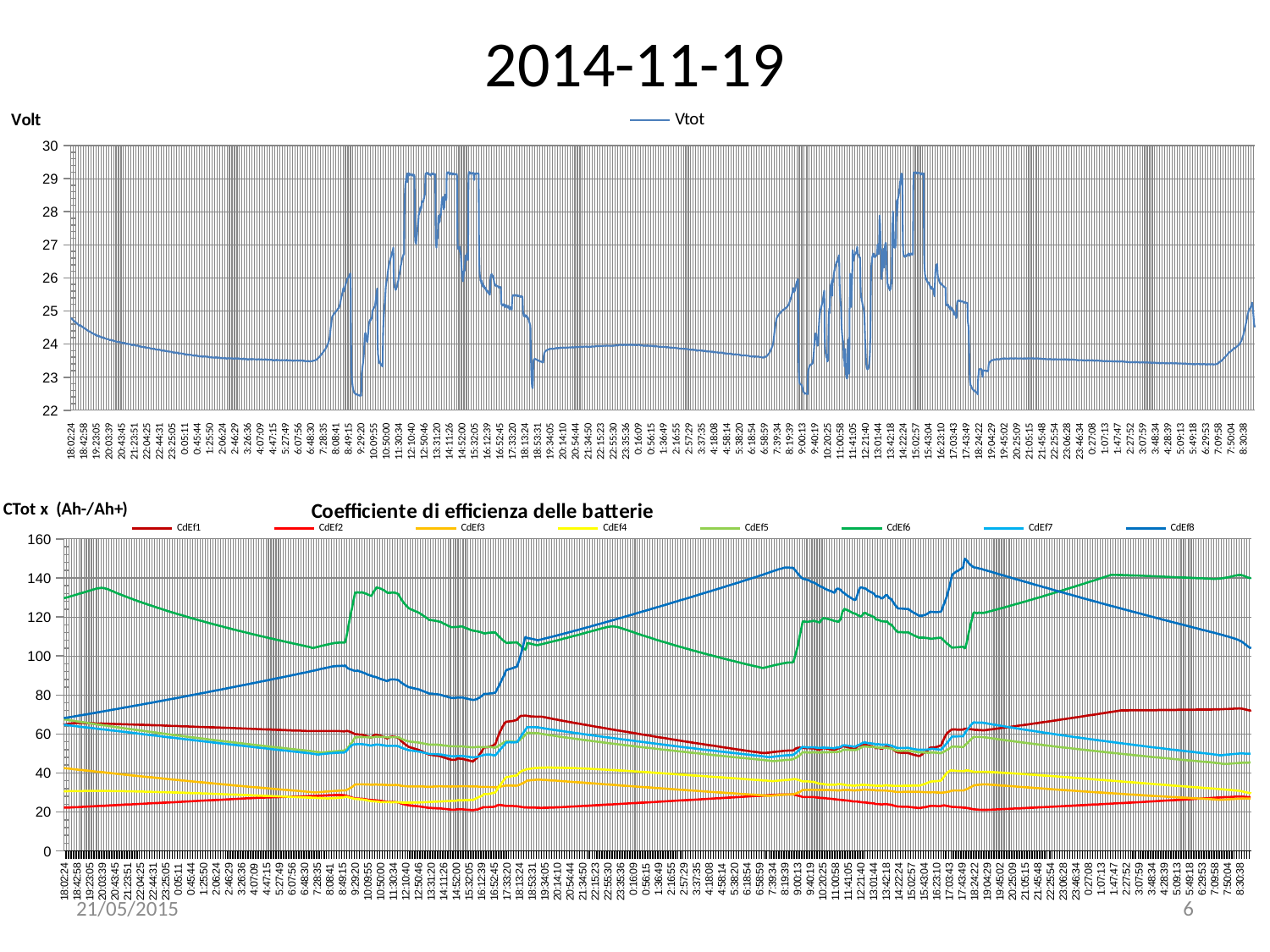
What is the label on the vertical axis of the bottom chart? CTot x (Ah-/Ah+) In the bottom chart (Coefficiente di efficienza delle batterie), is the value of CdEf6 at 18:02:24 greater or less than 120? greater In the bottom chart (Coefficiente di efficienza delle batterie), which series has the highest value at the first time point, 18:02:24? CdEf6 How many series does the legend of the top chart (Volt) list? 1 In the bottom chart (Coefficiente di efficienza delle batterie), does CdEf8 rise or fall between 18:02:24 and 7:39:34? rise How many series does the legend of the bottom chart (Coefficiente di efficienza delle batterie) list? 8 In the bottom chart (Coefficiente di efficienza delle batterie), which series has the lowest value at the first time point, 18:02:24? CdEf2 In the top chart (Volt), does Vtot rise or fall between 18:02:24 and 5:27:49? fall What kind of chart is the top chart labelled Volt? line chart What is the title of the bottom chart? Coefficiente di efficienza delle batterie In the top chart (Volt), is the highest value reached by Vtot greater or less than 28? greater In the top chart (Volt), is the lowest value reached by Vtot greater or less than 23? less